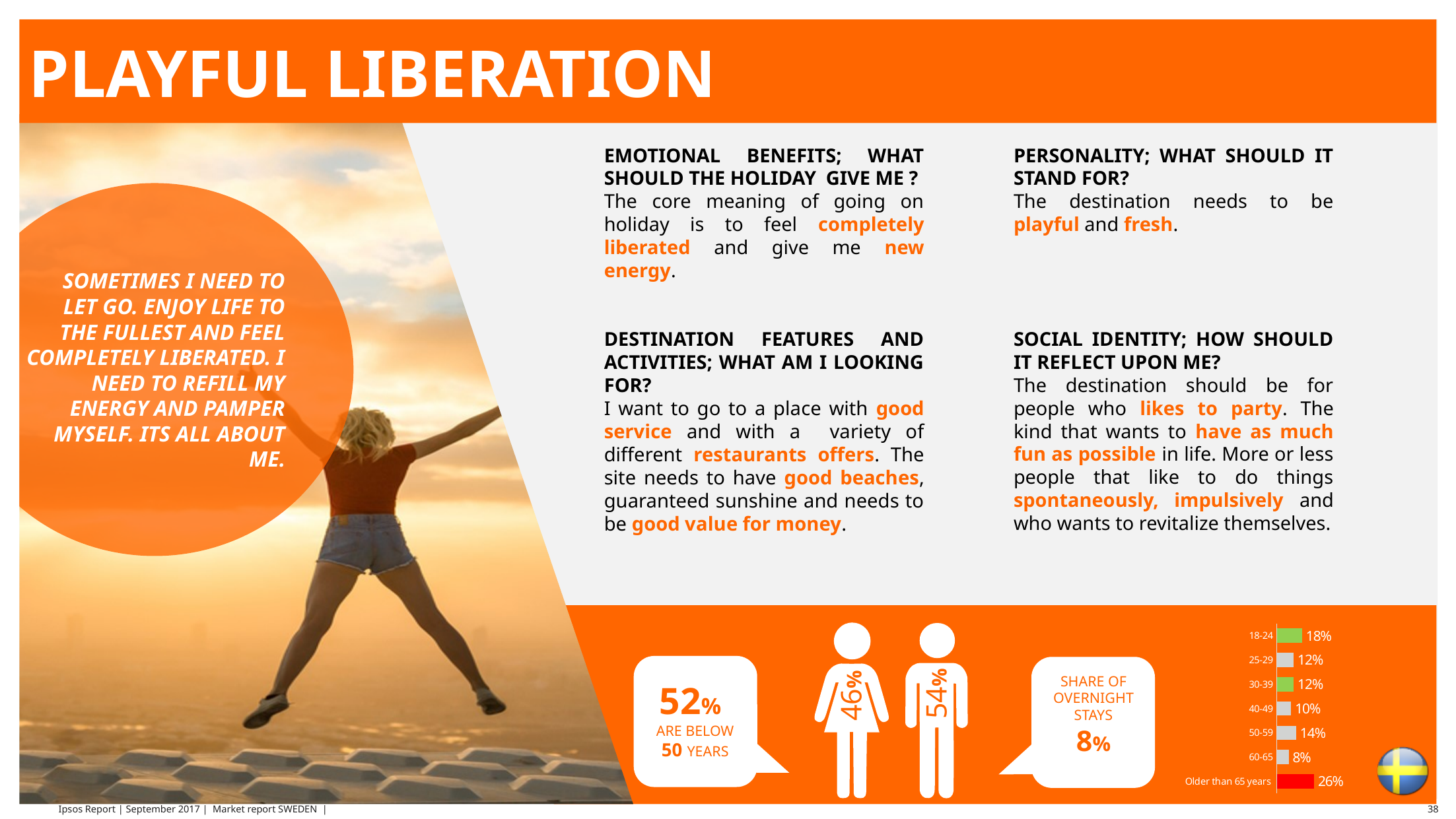
In the age-group bar chart at the bottom right, which age group has the highest value? Older than 65 years In the age-group bar chart at the bottom right, what is the value for the 18-24 group? 18% What kind of chart is used to show the age groups at the bottom right of the slide? Bar chart How many age groups are shown in the bar chart at the bottom right? 7 In the age-group bar chart at the bottom right, what colour is the bar for 'Older than 65 years'? Red In the age-group bar chart at the bottom right, what is the value for 'Older than 65 years'? 26% In the age-group bar chart at the bottom right, which age group has the lowest value? 60-65 According to the infographic at the bottom of the slide, what percentage are below 50 years? 52% In the age-group bar chart at the bottom right, what is the value for the 40-49 group? 10% In the age-group bar chart at the bottom right, what is the difference between the values for 'Older than 65 years' and 18-24? 8% In the age-group bar chart at the bottom right, which is larger: the value for 50-59 or the value for 40-49? 50-59 In the age-group bar chart at the bottom right, what is the value for the 50-59 group? 14%